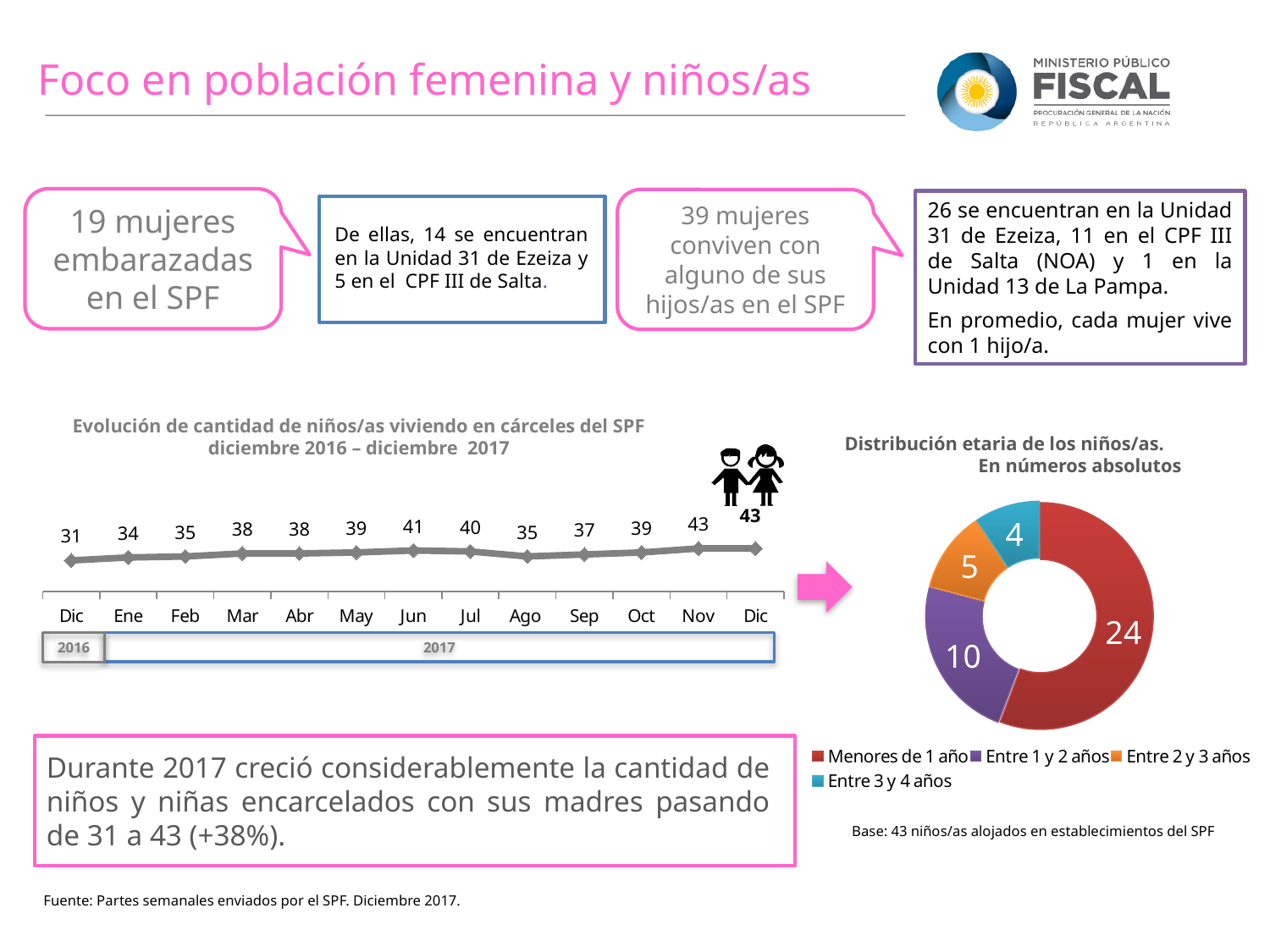
In the line chart 'Evolución de cantidad de niños/as viviendo en cárceles del SPF', which is larger, the value for Jul or the value for Ago? Jul How many categories does the legend of the donut chart 'Distribución etaria de los niños/as' list? 4 In the line chart 'Evolución de cantidad de niños/as viviendo en cárceles del SPF', which month has the lowest value? Dic 2016 In the line chart 'Evolución de cantidad de niños/as viviendo en cárceles del SPF', what is the value for Jun? 41 What kind of chart is 'Evolución de cantidad de niños/as viviendo en cárceles del SPF'? Line chart How many data points are plotted in the line chart 'Evolución de cantidad de niños/as viviendo en cárceles del SPF'? 13 In the line chart 'Evolución de cantidad de niños/as viviendo en cárceles del SPF', do the values rise or fall from Dic 2016 to Dic 2017 overall? Rise In the donut chart 'Distribución etaria de los niños/as', what is the value for 'Menores de 1 año'? 24 In the donut chart 'Distribución etaria de los niños/as', what is the difference between 'Entre 1 y 2 años' and 'Entre 2 y 3 años'? 5 In the line chart 'Evolución de cantidad de niños/as viviendo en cárceles del SPF', what is the value for Dic 2016? 31 In the donut chart 'Distribución etaria de los niños/as', which age group has the smallest value? Entre 3 y 4 años In the line chart 'Evolución de cantidad de niños/as viviendo en cárceles del SPF', what is the difference between the value for Dic 2017 and the value for Dic 2016? 12